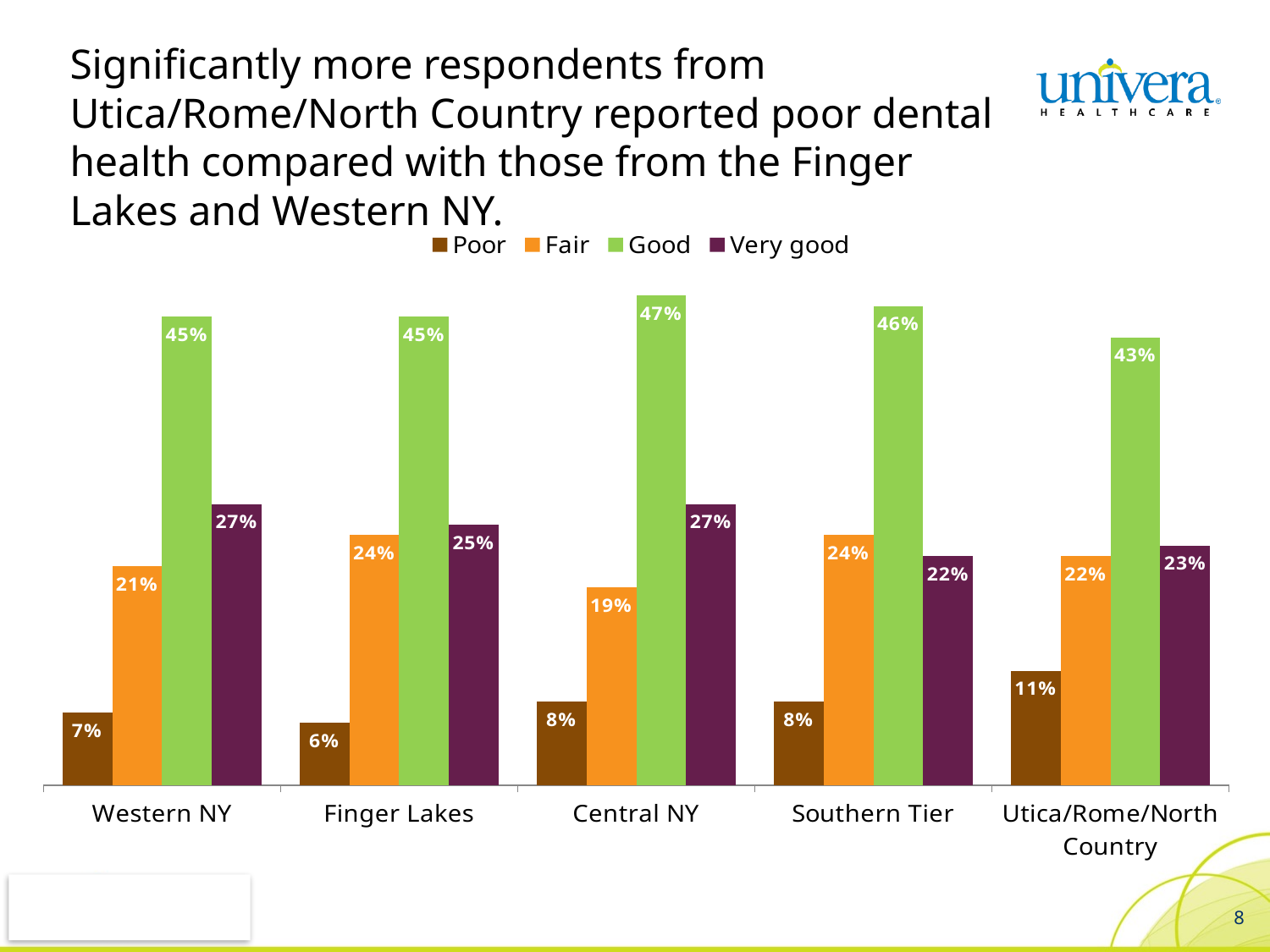
What percentage of respondents from Finger Lakes reported fair dental health? 24% What kind of chart is shown on the slide? Bar chart Which region has the lowest percentage of respondents reporting poor dental health? Finger Lakes Which region has the lowest percentage of respondents reporting good dental health? Utica/Rome/North Country What percentage of respondents from Central NY reported good dental health? 47% Which series is shown in green in the legend? Good Which is larger: the very good percentage for Western NY or for Southern Tier? Western NY How many series does the legend list? 4 Which region has the highest percentage of respondents reporting poor dental health? Utica/Rome/North Country What percentage of respondents from Utica/Rome/North Country reported poor dental health? 11% What is the difference between the poor dental health percentages for Utica/Rome/North Country and Finger Lakes? 5% How many regions are shown on the x axis? 5